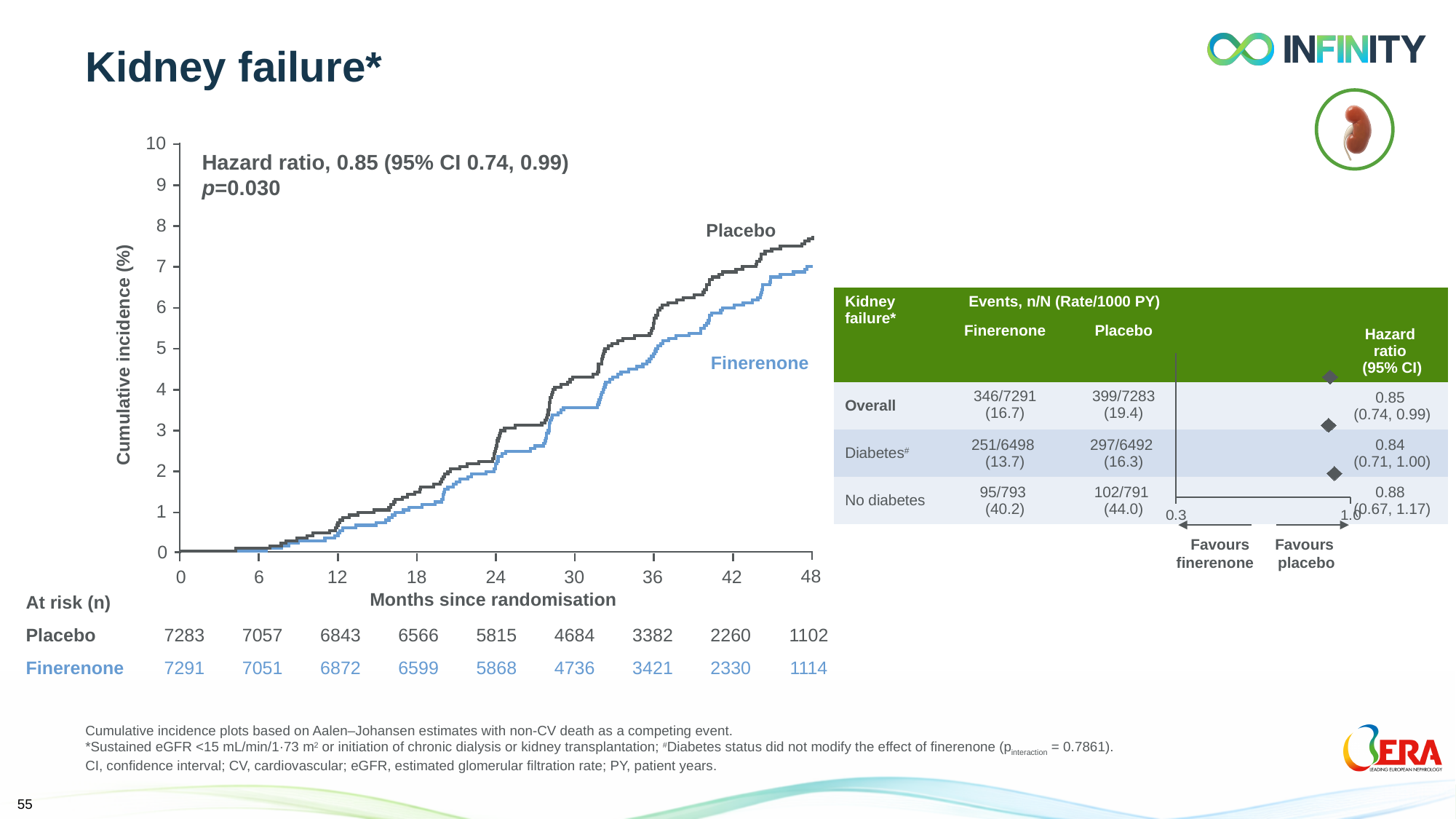
In the cumulative incidence chart, is the Placebo curve at 48 months greater or less than 7%? greater In the cumulative incidence chart, do the curves rise or fall as months since randomisation increase? Rise In the cumulative incidence chart, is the Finerenone curve at 48 months greater or less than 8%? less What is the p-value printed on the cumulative incidence chart? p=0.030 In the at-risk table below the chart, how many Finerenone patients were at risk at 48 months? 1114 In the cumulative incidence chart, which group has the higher cumulative incidence at 48 months, Placebo or Finerenone? Placebo In the forest plot table on the right, what is the hazard ratio (95% CI) for the No diabetes subgroup? 0.88 (0.67, 1.17) What hazard ratio and 95% CI are printed on the cumulative incidence chart? 0.85 (95% CI 0.74, 0.99) In the at-risk table below the chart, how many Placebo patients were at risk at 0 months? 7283 How many treatment groups are plotted in the cumulative incidence chart? 2 What type of chart is the cumulative incidence plot on the left of the slide? Line chart In the forest plot table on the right, which subgroup has the lowest hazard ratio? Diabetes (0.84)